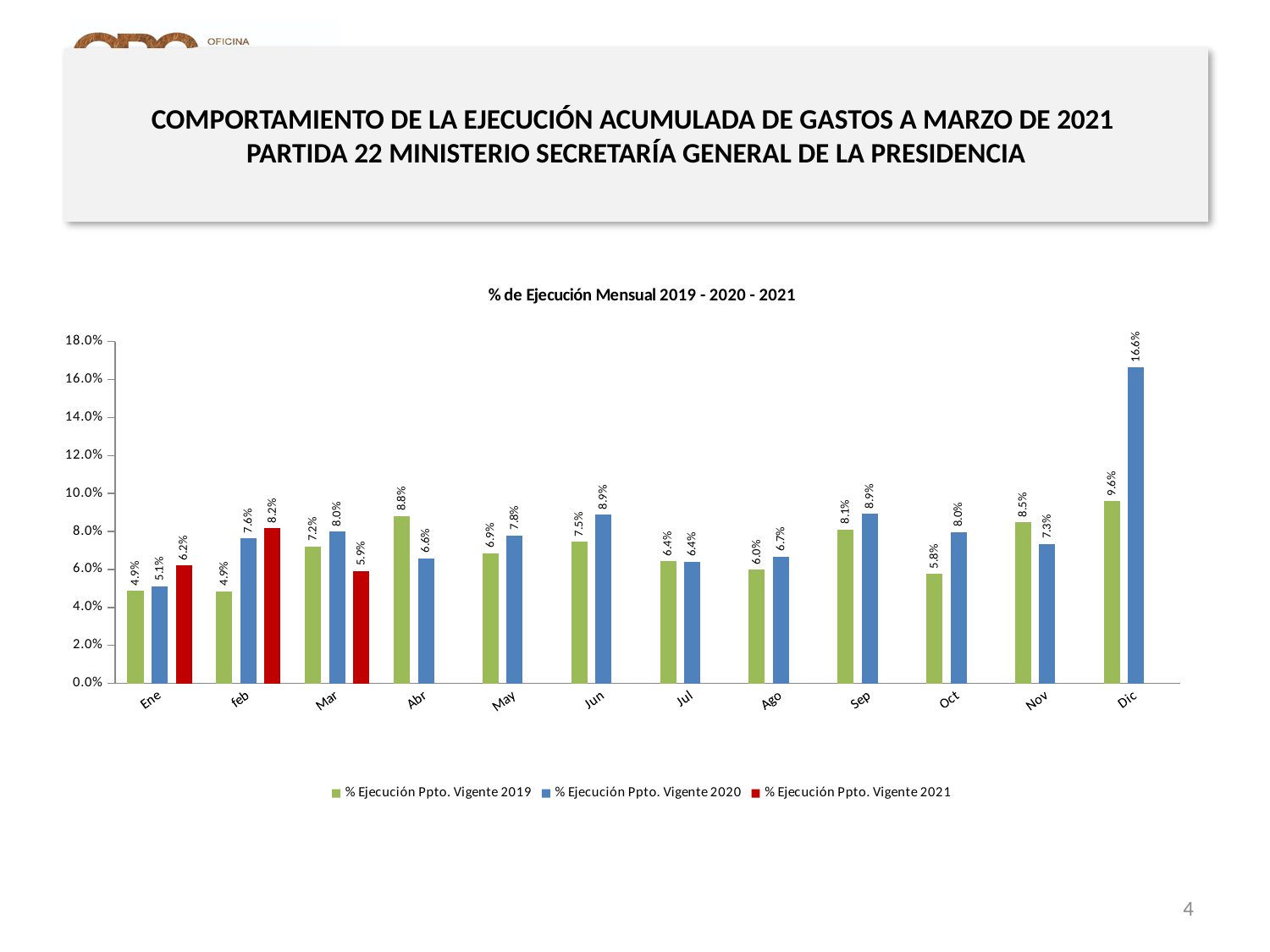
How many series does the legend list? 3 What is the title of the chart? % de Ejecución Mensual 2019 - 2020 - 2021 Which month has the highest value for % Ejecución Ppto. Vigente 2020? Dic What is the value for % Ejecución Ppto. Vigente 2021 in Mar? 5.9% What is the difference between the 2021 and 2019 values in feb? 3.3% What kind of chart is shown on the slide? bar chart What is the value for % Ejecución Ppto. Vigente 2019 in Abr? 8.8% How many months are shown on the x axis? 12 Which is larger in Nov: the 2019 value or the 2020 value? 2019 What is the value for % Ejecución Ppto. Vigente 2020 in Dic? 16.6% Is the value for % Ejecución Ppto. Vigente 2020 in Dic greater or less than 14.0%? greater